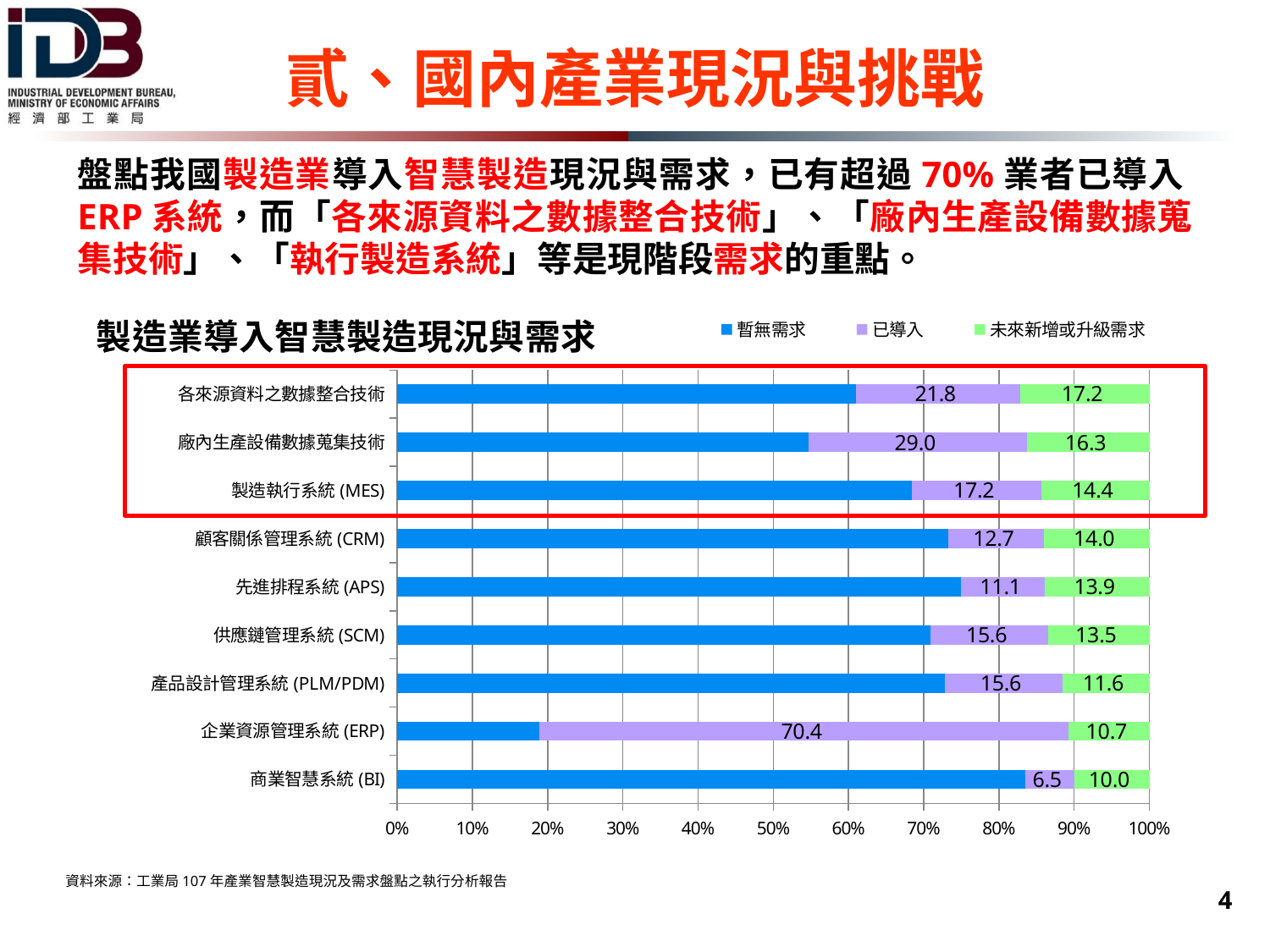
Which category has the highest 已導入 value? 企業資源管理系統 (ERP) Is the 暫無需求 value for 商業智慧系統 (BI) greater or less than 80%? greater How many series does the chart legend list? 3 What type of chart is shown on the slide? Stacked bar chart How many categories (systems/technologies) are plotted in the chart? 9 What is the 已導入 value for 企業資源管理系統 (ERP)? 70.4 Which has a larger 未來新增或升級需求 value: 顧客關係管理系統 (CRM) or 產品設計管理系統 (PLM/PDM)? 顧客關係管理系統 (CRM) Which series is shown in green in the chart? 未來新增或升級需求 What is the 已導入 value for 廠內生產設備數據蒐集技術? 29.0 What is the difference between the 已導入 values of 廠內生產設備數據蒐集技術 and 製造執行系統 (MES)? 11.8 Which category has the lowest 未來新增或升級需求 value? 商業智慧系統 (BI) What is the 未來新增或升級需求 value for 各來源資料之數據整合技術? 17.2